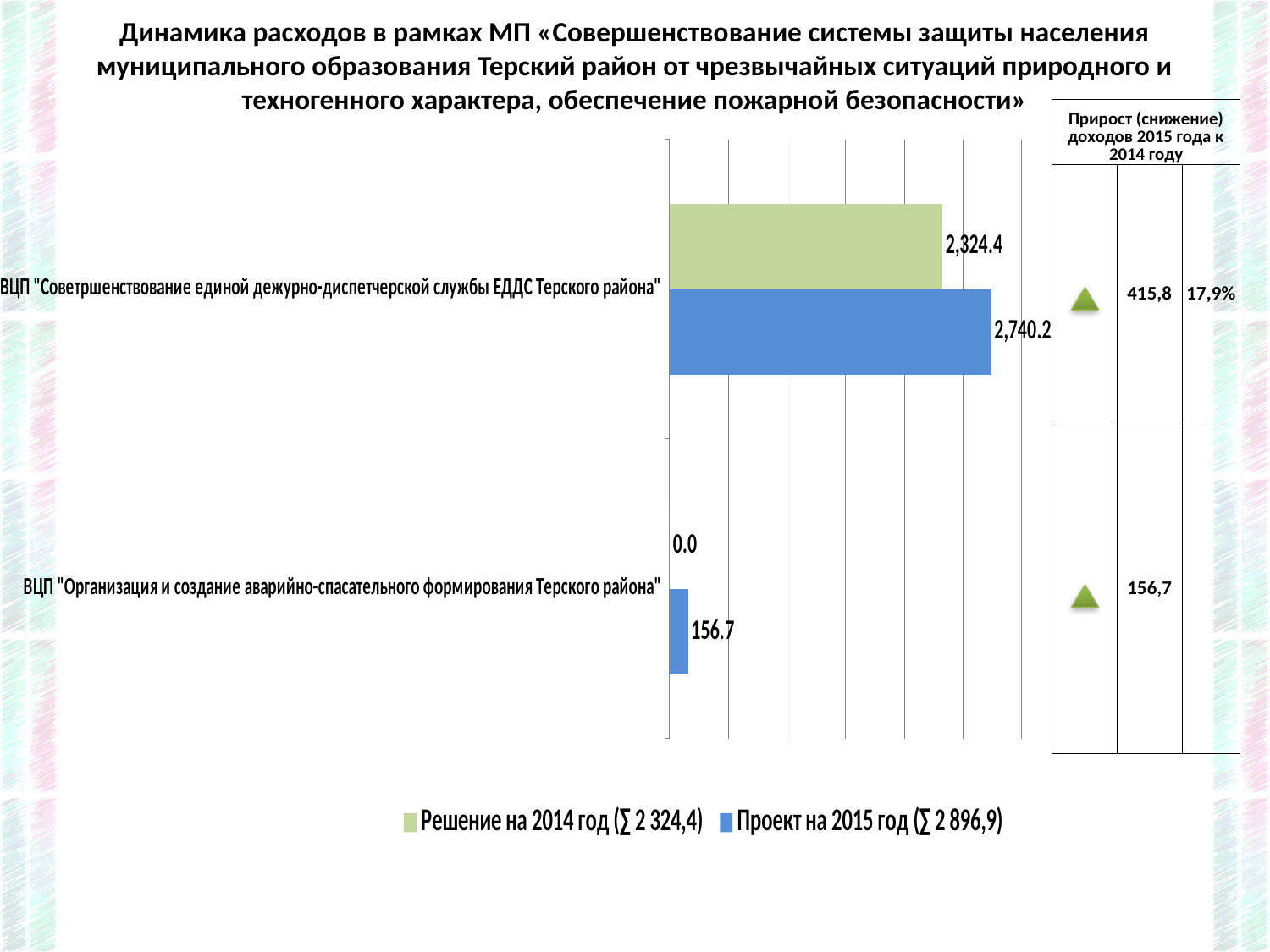
What percentage growth is shown in the side table for ВЦП "Советршенствование единой дежурно-диспетчерской службы ЕДДС Терского района"? 17,9% For ВЦП "Советршенствование единой дежурно-диспетчерской службы ЕДДС Терского района", which is larger: the 2014 value or the 2015 value? the 2015 value Which category has the highest value in the "Проект на 2015 год" series? ВЦП "Советршенствование единой дежурно-диспетчерской службы ЕДДС Терского района" How many series does the legend list? 2 What is the value of "Проект на 2015 год" for ВЦП "Советршенствование единой дежурно-диспетчерской службы ЕДДС Терского района"? 2,740.2 What is the value of "Решение на 2014 год" for ВЦП "Организация и создание аварийно-спасательного формирования Терского района"? 0.0 What type of chart is shown on the slide? bar chart What is the difference between the 2015 and 2014 values for ВЦП "Советршенствование единой дежурно-диспетчерской службы ЕДДС Терского района"? 415.8 What is the value of "Проект на 2015 год" for ВЦП "Организация и создание аварийно-спасательного формирования Терского района"? 156.7 What is the value of "Решение на 2014 год" for ВЦП "Советршенствование единой дежурно-диспетчерской службы ЕДДС Терского района"? 2,324.4 How many categories are plotted on the chart? 2 What total is shown in the legend for the series "Проект на 2015 год"? ∑ 2 896,9